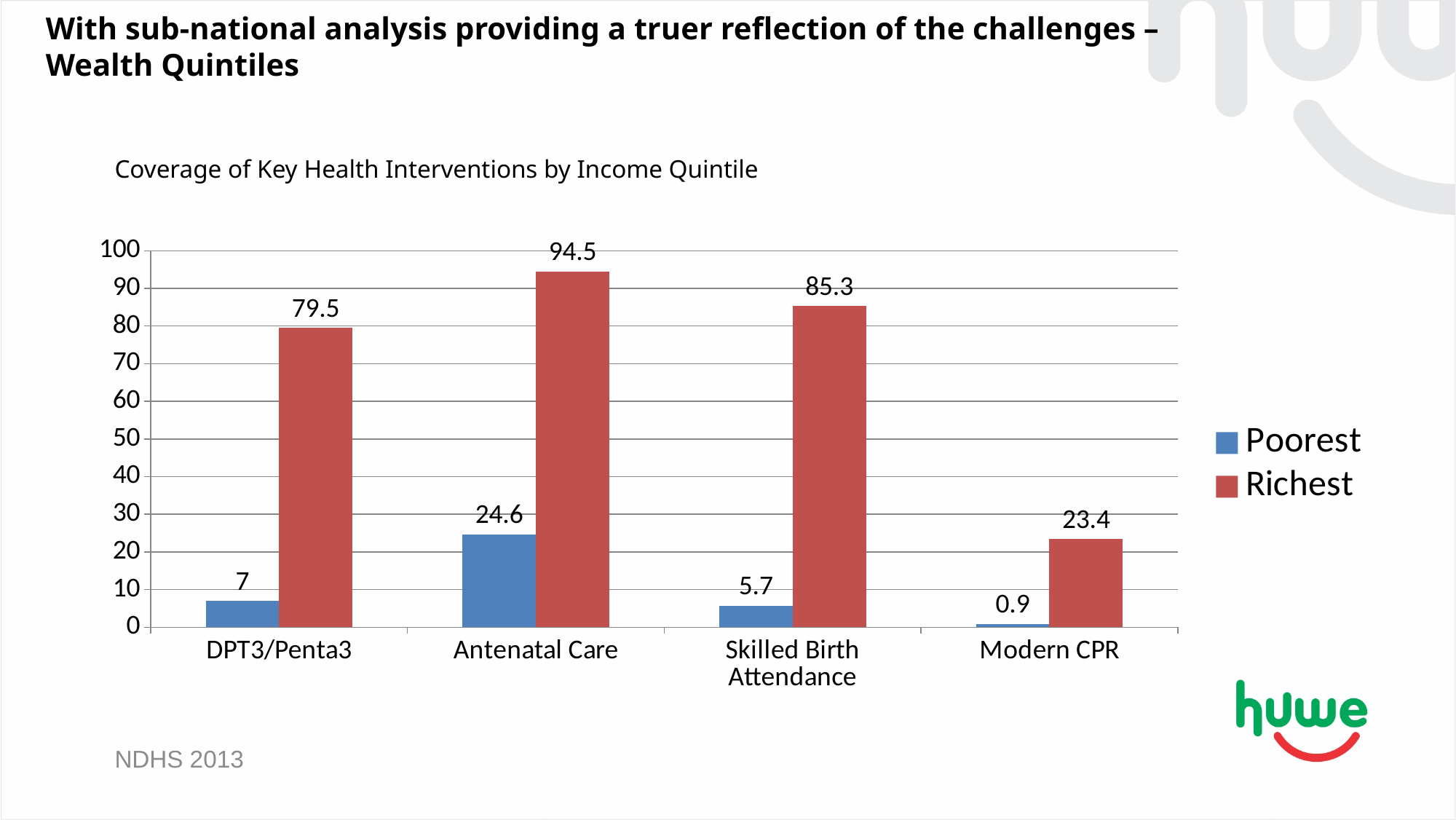
What is the difference between the Richest and Poorest values for DPT3/Penta3? 72.5 What is the Richest value for Antenatal Care? 94.5 What is the Richest value for Skilled Birth Attendance? 85.3 What is the title of the chart? Coverage of Key Health Interventions by Income Quintile Which is larger, the Poorest value for Antenatal Care or the Richest value for Modern CPR? Poorest value for Antenatal Care What kind of chart is shown? Bar chart What is the Poorest value for DPT3/Penta3? 7 How many categories are shown on the x axis? 4 Which category has the highest Richest value? Antenatal Care What is the Poorest value for Modern CPR? 0.9 Which category has the lowest Poorest value? Modern CPR How many series does the legend list? 2